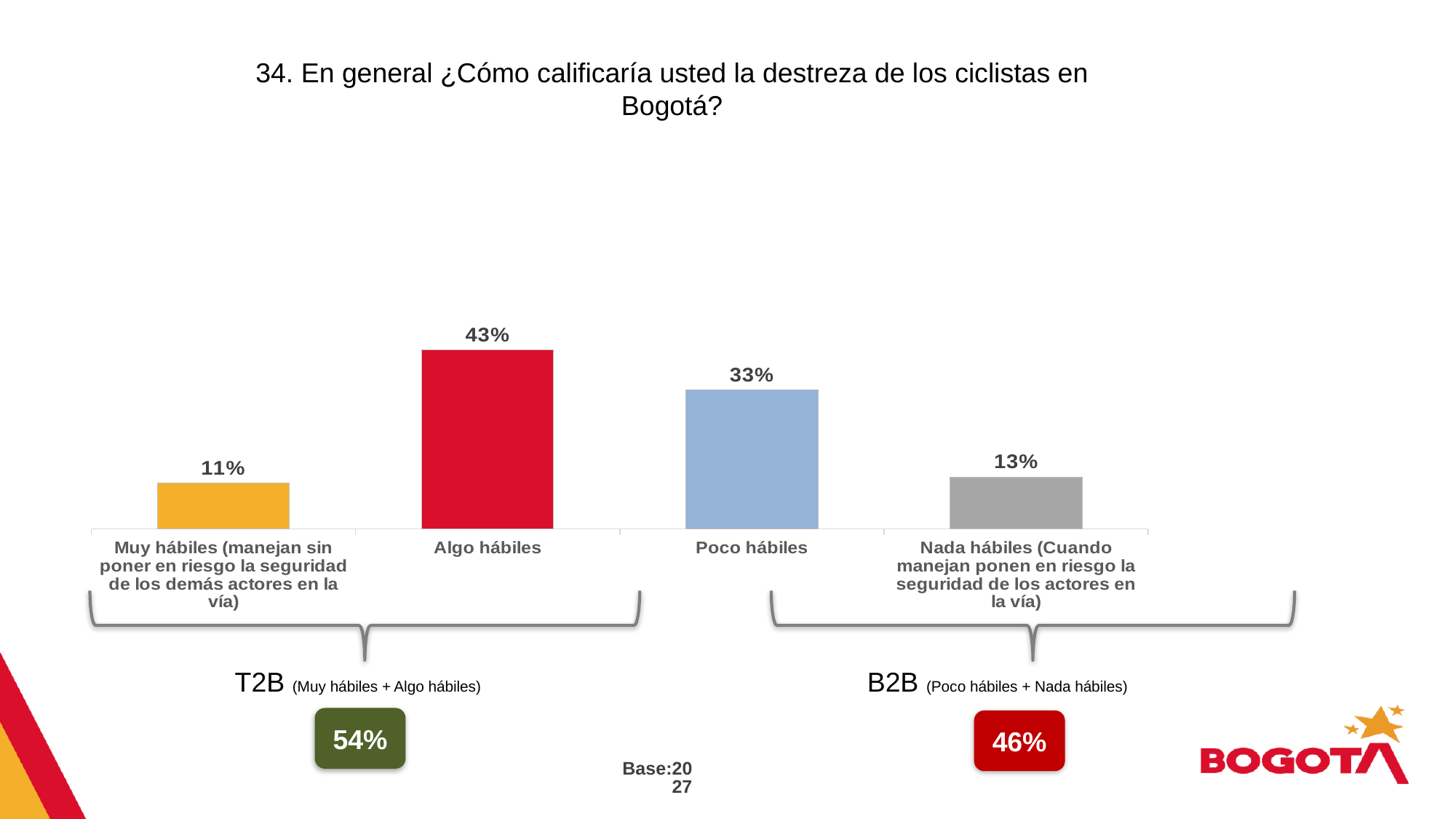
What percentage of respondents rated cyclists as "Poco hábiles"? 33% What percentage of respondents rated cyclists as "Algo hábiles"? 43% What is the difference between the values for "Algo hábiles" and "Poco hábiles"? 10% Which category has the lowest value? Muy hábiles Which category has the highest value? Algo hábiles What is the value shown for "Nada hábiles"? 13% What is the T2B value (Muy hábiles + Algo hábiles) shown on the slide? 54% What is the value shown for "Muy hábiles"? 11% What kind of chart is shown on the slide? Bar chart What is the B2B value (Poco hábiles + Nada hábiles) shown on the slide? 46% How many categories are shown in the bar chart? 4 Which is larger, the value for "Nada hábiles" or the value for "Muy hábiles"? Nada hábiles